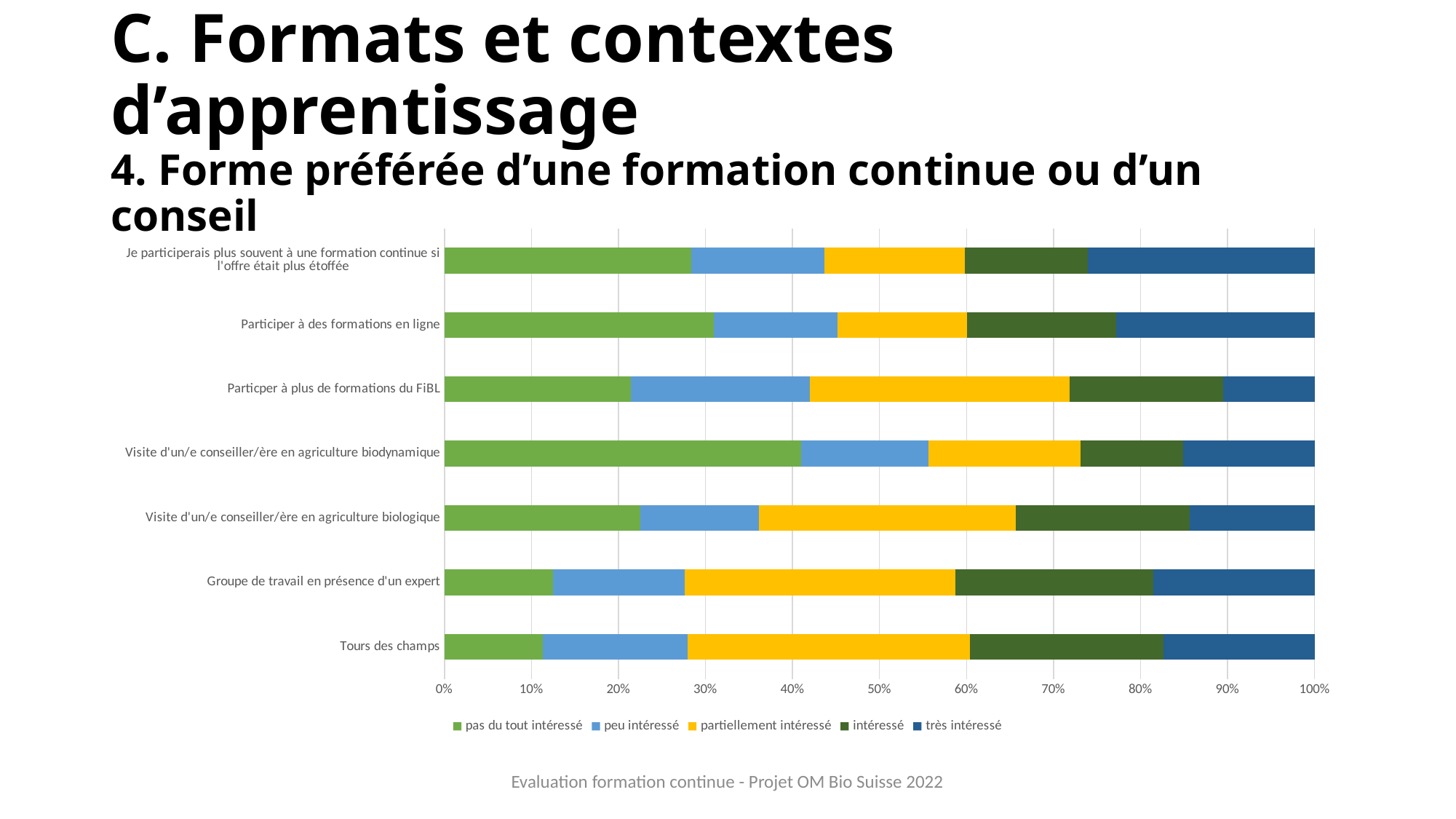
Is the 'pas du tout intéressé' share for 'Visite d'un/e conseiller/ère en agriculture biodynamique' greater or less than 30%? greater Which has a larger 'pas du tout intéressé' segment: 'Participer à des formations en ligne' or 'Tours des champs'? Participer à des formations en ligne Is the 'pas du tout intéressé' share for 'Groupe de travail en présence d'un expert' greater or less than 20%? less How many categories (learning formats) are plotted on the chart? 7 Is the 'pas du tout intéressé' share for 'Tours des champs' greater or less than 20%? less Which category has the largest 'pas du tout intéressé' segment? Visite d'un/e conseiller/ère en agriculture biodynamique Which legend entry is shown in yellow? partiellement intéressé How many series does the legend list? 5 What kind of chart is shown on the slide? stacked bar chart What is the maximum value shown on the x axis? 100% What does each stacked bar total on the x axis? 100%